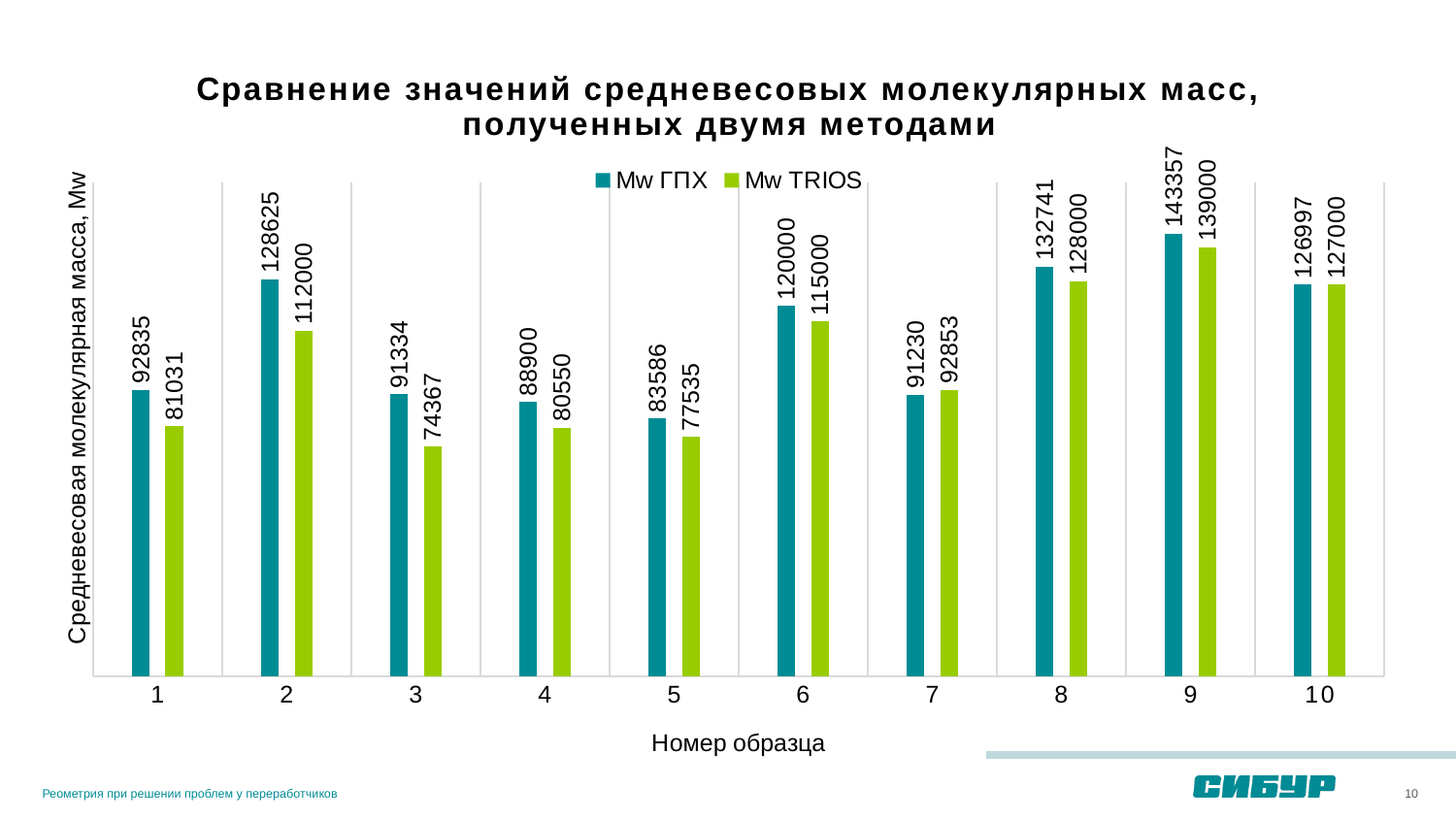
What is the Mw ГПХ value for sample 7? 91230 What is the difference between the Mw ГПХ and Mw TRIOS values for sample 2? 16625 What is the difference between the Mw ГПХ values for sample 9 and sample 8? 10616 Which sample has the lowest Mw TRIOS value? 3 What kind of chart is shown on the slide? Bar chart How many series does the legend list? 2 Which is larger for sample 3: the Mw ГПХ value or the Mw TRIOS value? Mw ГПХ How many samples are shown on the x axis? 10 What is the label of the x axis? Номер образца What is the Mw ГПХ value for sample 2? 128625 What is the Mw TRIOS value for sample 5? 77535 Which sample has the highest Mw ГПХ value? 9